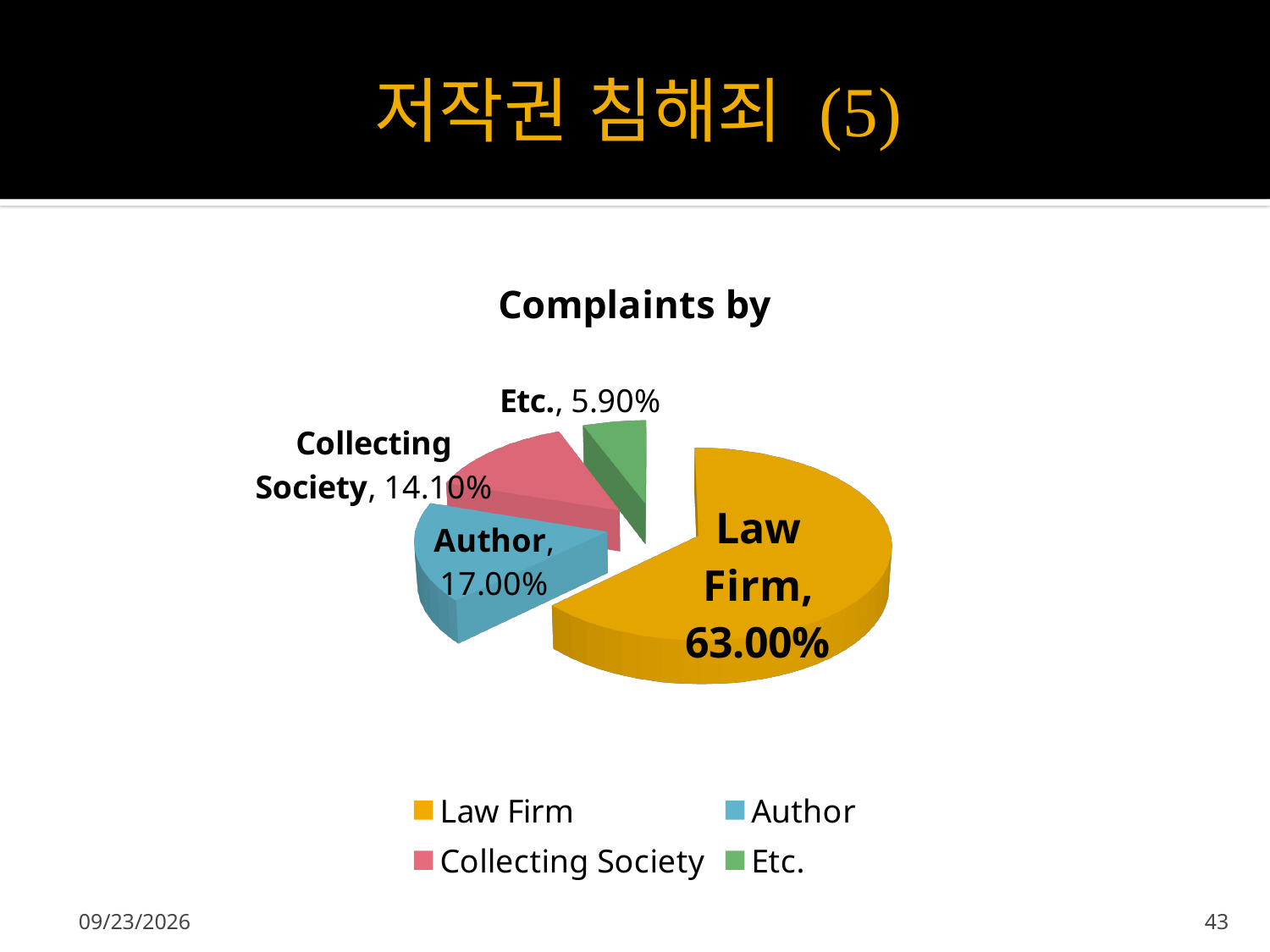
What is the difference between the Law Firm share and the Author share? 46.00% What share of complaints is attributed to Etc.? 5.90% How many categories does the pie chart show? 4 What is the title of the chart? Complaints by Which is larger, the share for Author or the share for Collecting Society? Author Which category has the smallest share of complaints? Etc. What share of complaints is attributed to Law Firm? 63.00% What colour is the Collecting Society slice? Red What share of complaints is attributed to Collecting Society? 14.10% Which category has the largest share of complaints? Law Firm What type of chart is shown on the slide? Pie chart What share of complaints is attributed to Author? 17.00%